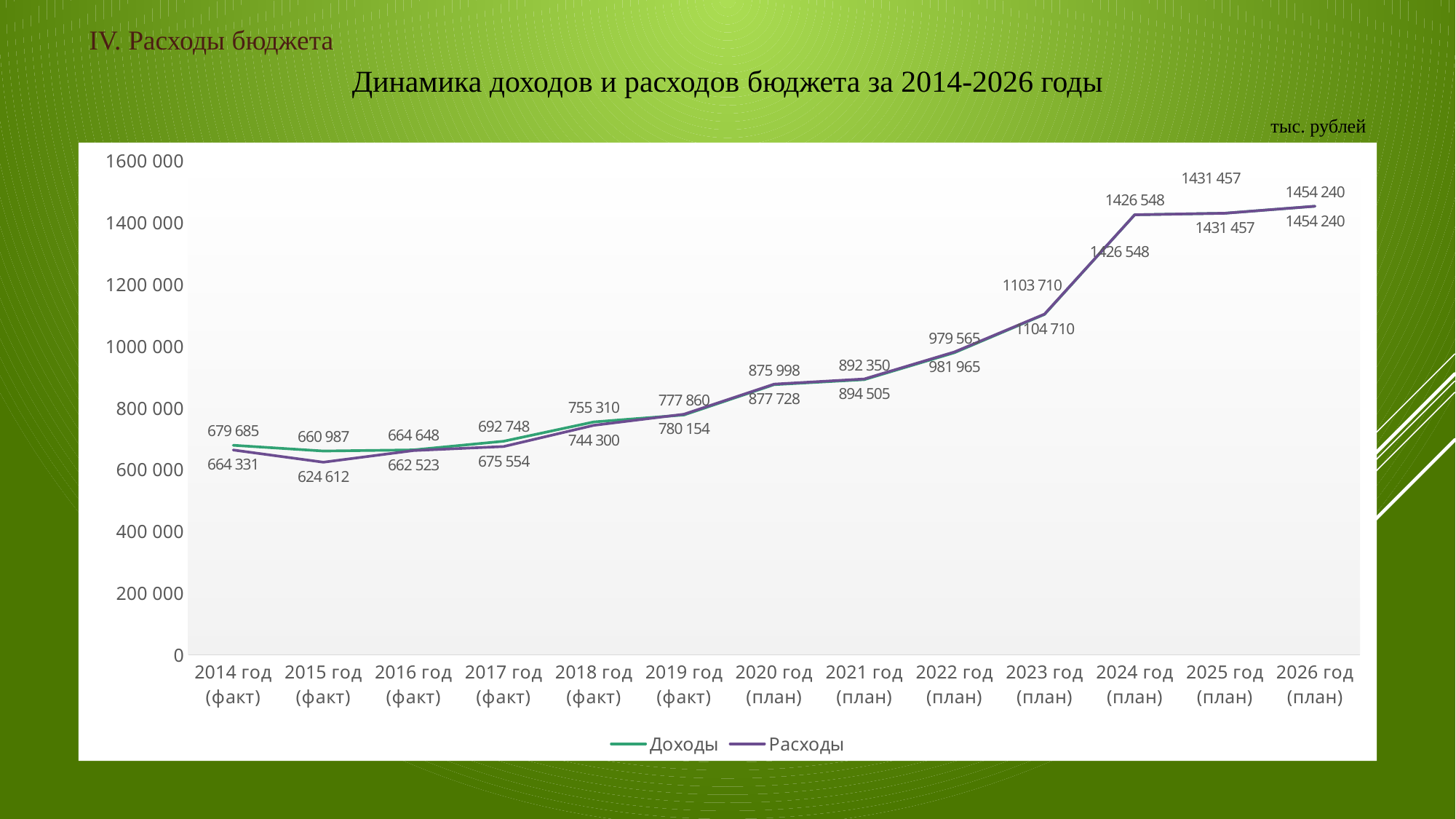
How many years (categories) are plotted along the x axis? 13 What is the value of Расходы for 2026 год (план)? 1454 240 What is the value of Доходы for 2023 год (план)? 1103 710 How many series does the legend list? 2 What is the difference between Доходы and Расходы in 2014 год (факт)? 15 354 In which year is the value of Доходы the highest? 2026 год (план) Which is larger in 2015 год (факт): Доходы or Расходы? Доходы What is the value of Расходы for 2015 год (факт)? 624 612 What type of chart is shown on the slide? line chart In which year is the value of Расходы the lowest? 2015 год (факт) What is the value of Доходы for 2014 год (факт)? 679 685 Do the values of Расходы generally rise or fall from 2016 to 2026? rise